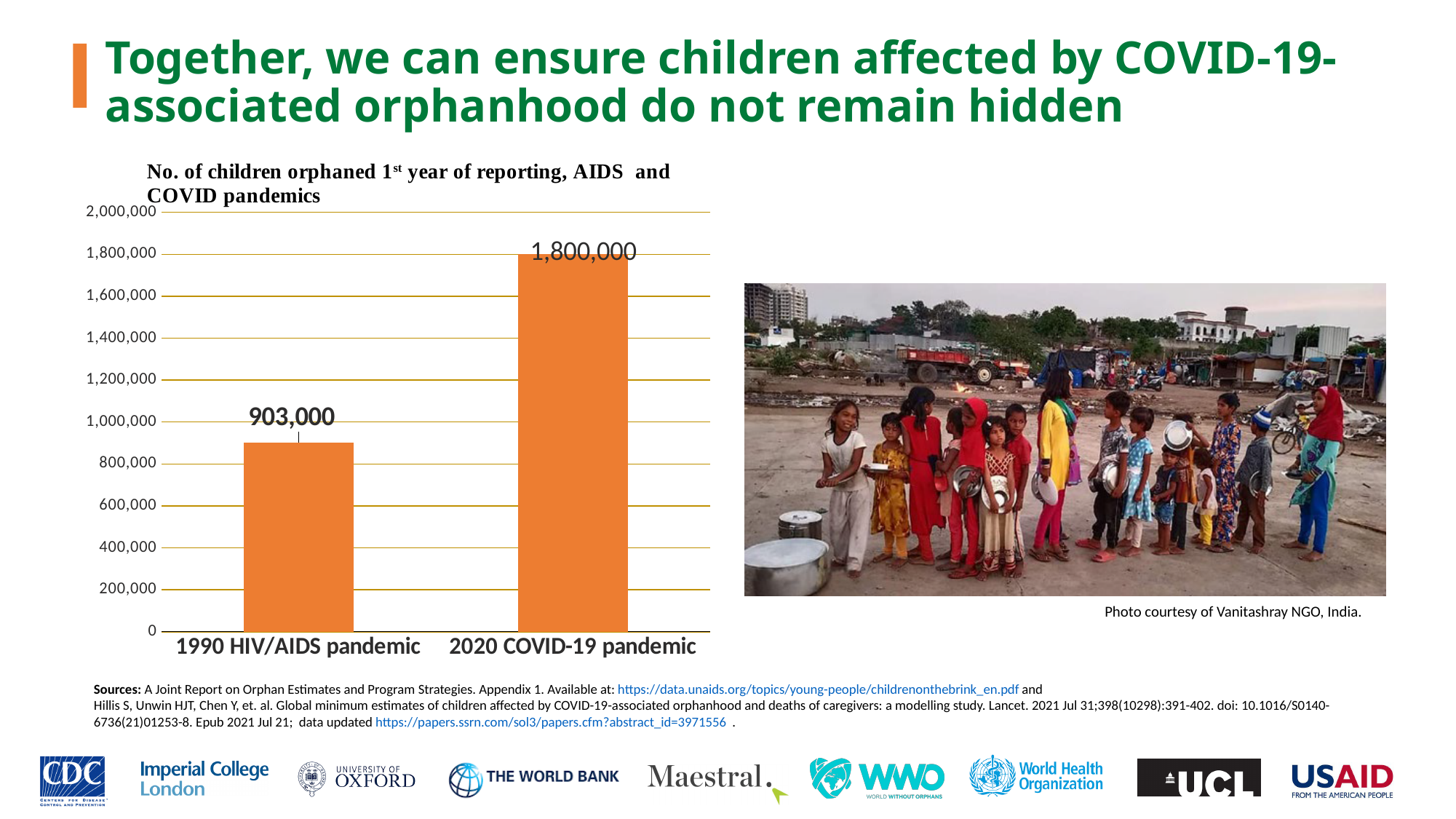
What kind of chart is shown on the slide? bar chart How many categories are shown on the chart? 2 Which pandemic has the higher number of children orphaned in the first year of reporting? 2020 COVID-19 pandemic What is the difference between the number of children orphaned in the 2020 COVID-19 pandemic and the 1990 HIV/AIDS pandemic? 897,000 Which pandemic has the lower number of children orphaned in the first year of reporting? 1990 HIV/AIDS pandemic What is the title of the chart? No. of children orphaned 1st year of reporting, AIDS and COVID pandemics What colour are the bars in the chart? orange Is the value for the 2020 COVID-19 pandemic greater or less than 1,600,000? greater Is the value for the 1990 HIV/AIDS pandemic larger or smaller than the value for the 2020 COVID-19 pandemic? smaller What is the number of children orphaned in the first year of reporting for the 2020 COVID-19 pandemic? 1,800,000 Is the value for the 1990 HIV/AIDS pandemic greater or less than 1,000,000? less What is the number of children orphaned in the first year of reporting for the 1990 HIV/AIDS pandemic? 903,000